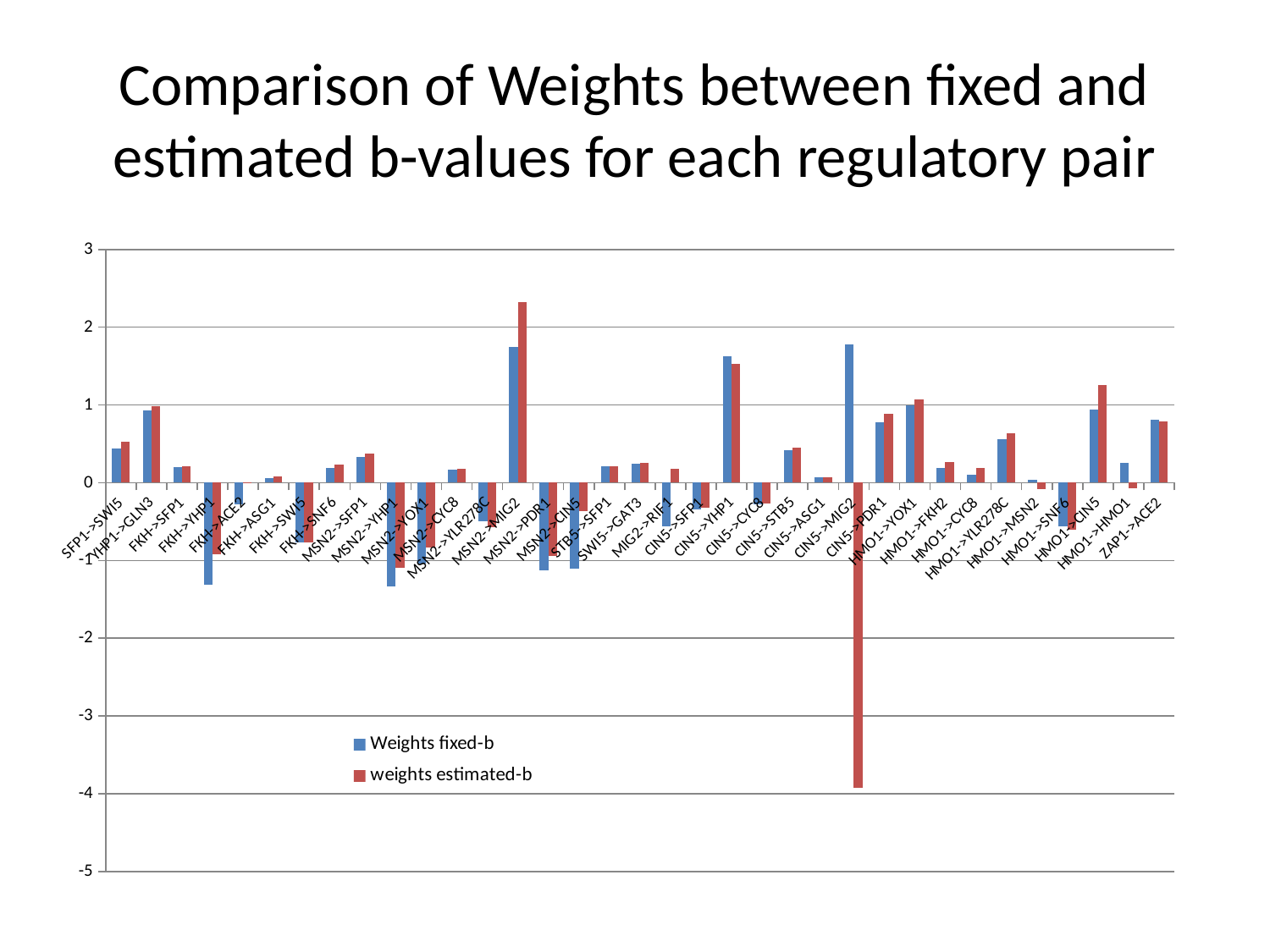
Is the Weights fixed-b value for FKH->YHP1 greater or less than -1? less For MSN2->MIG2, which is larger: the Weights fixed-b value or the weights estimated-b value? weights estimated-b How many series does the legend list? 2 Which regulatory pair has the highest value for the weights estimated-b series? MSN2->MIG2 Is the Weights fixed-b value for CIN5->MIG2 greater or less than 1? greater Is the weights estimated-b value for CIN5->MIG2 greater or less than -3? less What kind of chart is shown on the slide? bar chart What are the two series named in the legend? Weights fixed-b and weights estimated-b Which regulatory pair has the lowest value for the weights estimated-b series? CIN5->MIG2 For HMO1->CIN5, which is larger: the Weights fixed-b value or the weights estimated-b value? weights estimated-b What colour are the bars for the weights estimated-b series? red